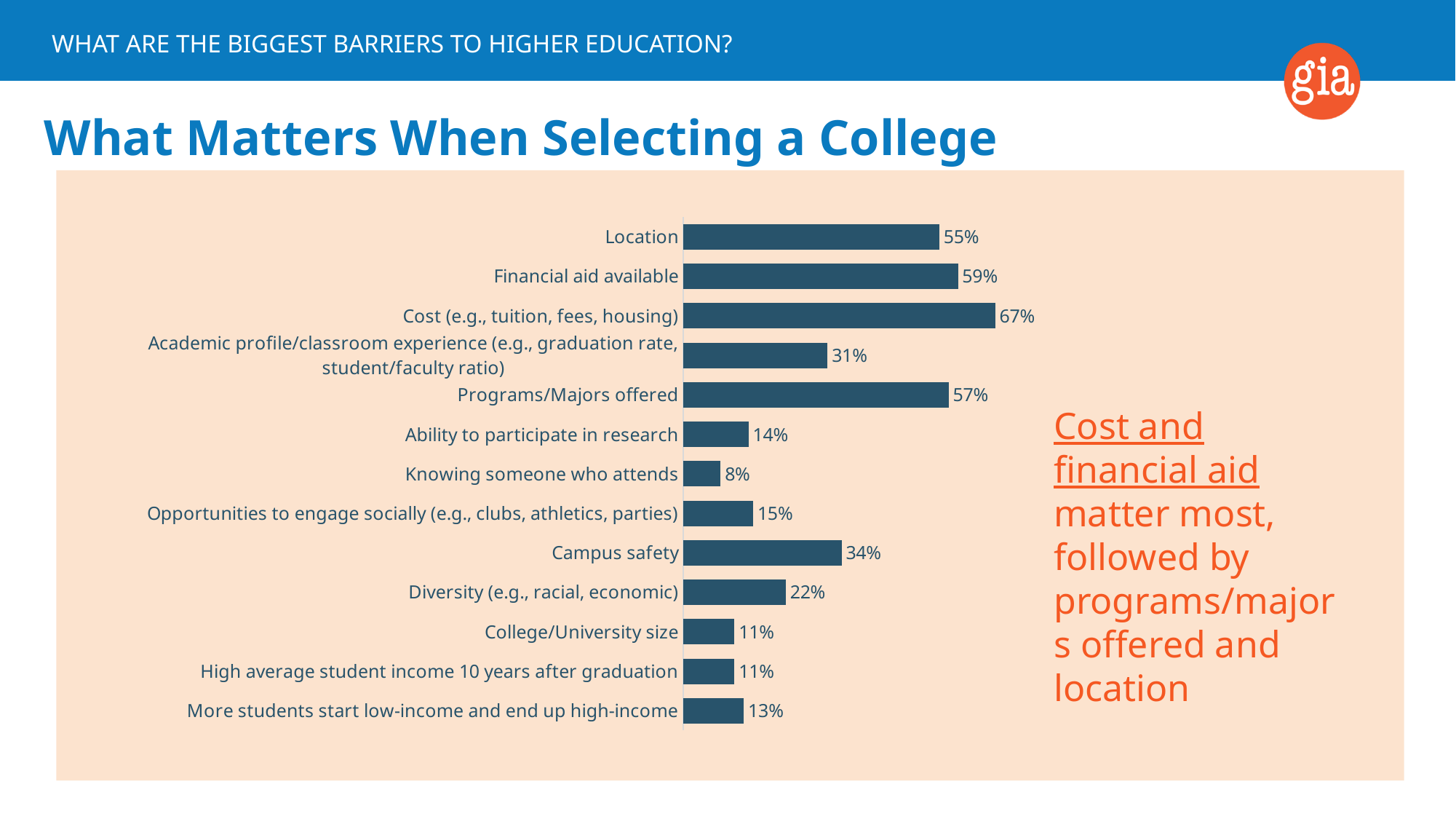
How many categories are shown in the chart? 13 What is the difference between the values for Cost (e.g., tuition, fees, housing) and Location? 12% Which category has the lowest value in the chart? Knowing someone who attends Which is larger, the value for Programs/Majors offered or the value for Location? Programs/Majors offered What is the difference between the values for Campus safety and Ability to participate in research? 20% What percentage of respondents said Cost (e.g., tuition, fees, housing) matters when selecting a college? 67% What is the value for Campus safety? 34% What kind of chart is shown on the slide? Bar chart What is the value for Diversity (e.g., racial, economic)? 22% What is the value for Financial aid available? 59% Which category has the highest value in the chart? Cost (e.g., tuition, fees, housing) What is the title of the slide containing the chart? What Matters When Selecting a College